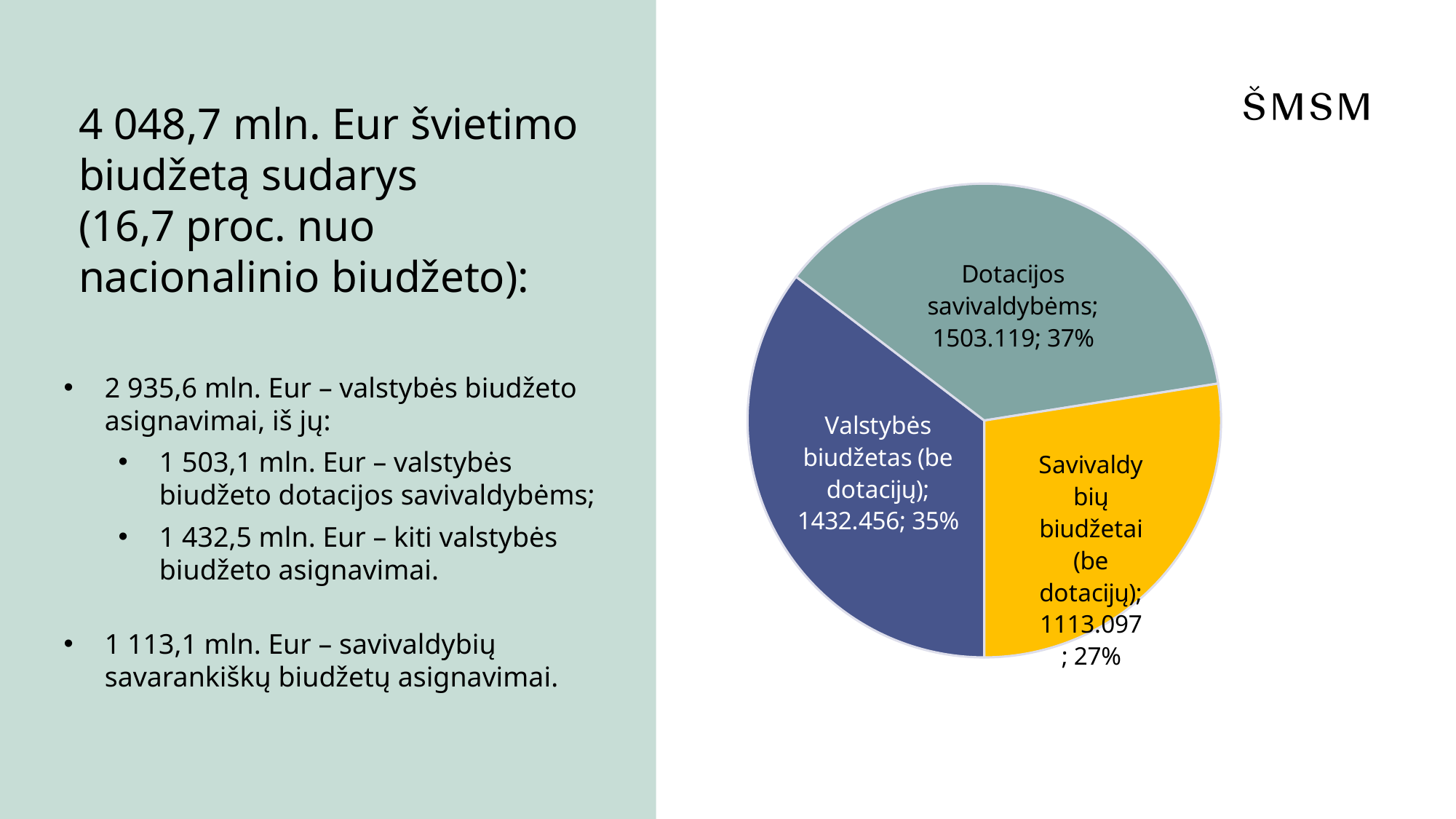
Which slice of the pie chart is the largest? Dotacijos savivaldybėms Which is larger: 'Valstybės biudžetas (be dotacijų)' or 'Savivaldybių biudžetai (be dotacijų)'? Valstybės biudžetas (be dotacijų) What value is shown for the slice 'Valstybės biudžetas (be dotacijų)'? 1432.456 What is the difference between the values for 'Dotacijos savivaldybėms' and 'Valstybės biudžetas (be dotacijų)'? 70.663 How many slices does the pie chart have? 3 What type of chart is shown on the slide? Pie chart What share of the pie does 'Savivaldybių biudžetai (be dotacijų)' represent? 27% What colour is the slice for 'Savivaldybių biudžetai (be dotacijų)'? Yellow Which slice of the pie chart is the smallest? Savivaldybių biudžetai (be dotacijų) What share of the pie does 'Dotacijos savivaldybėms' represent? 37% What value is shown for the slice 'Dotacijos savivaldybėms'? 1503.119 What value is shown for the slice 'Savivaldybių biudžetai (be dotacijų)'? 1113.097